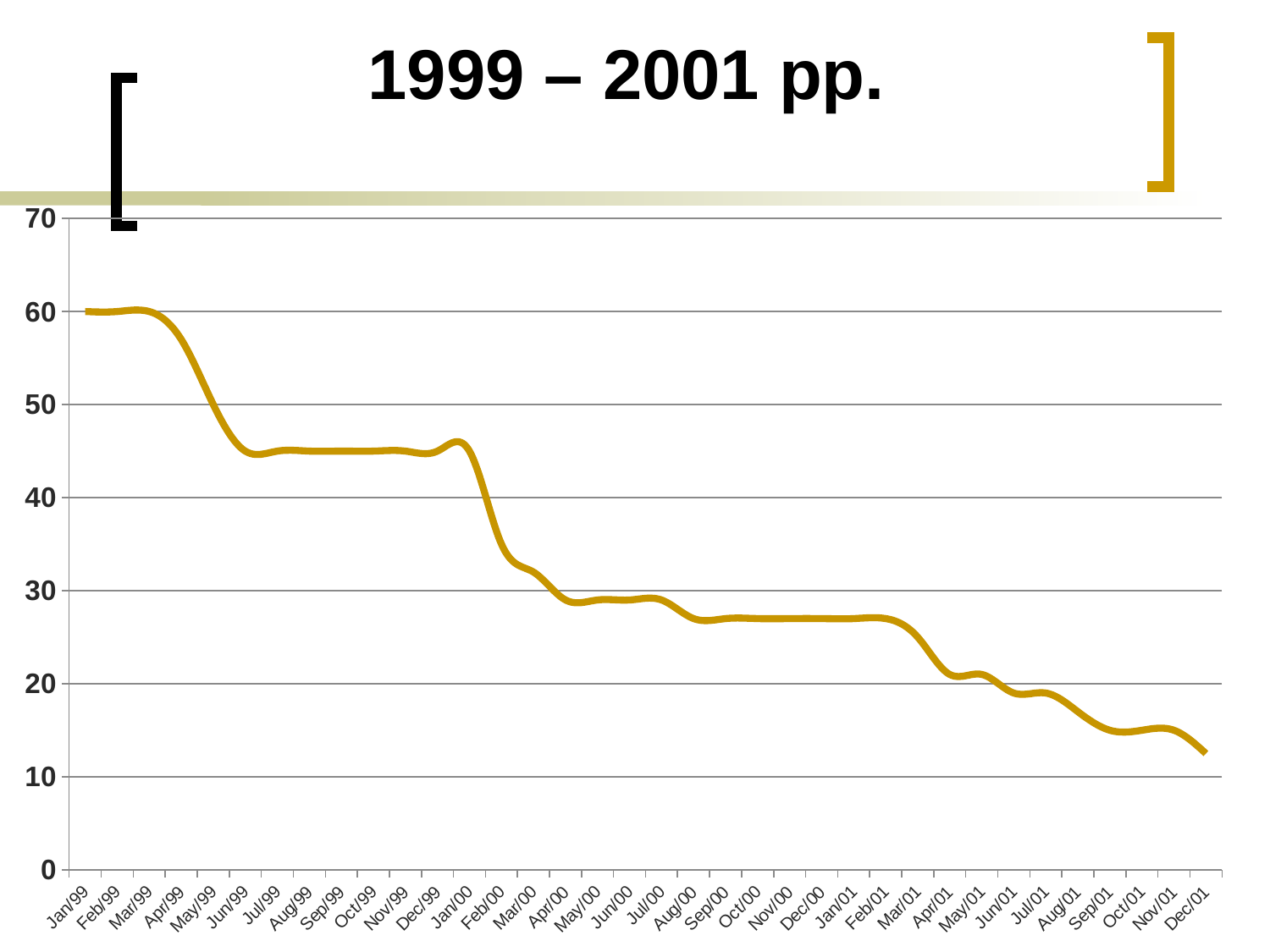
Do the values generally rise or fall from Jan/99 to Dec/01? fall What is the title of the chart? 1999 – 2001 pp. Is the value for Apr/01 greater or less than 30? less Is the value for Dec/01 greater or less than 20? less What kind of chart is shown on the slide? line chart Is the value for Mar/00 greater or less than 40? less Which month has the lowest value on the chart? Dec/01 How many monthly data points are plotted on the x axis? 36 What colour is the plotted line? gold Which is larger, the value for Jun/99 or the value for Jun/00? Jun/99